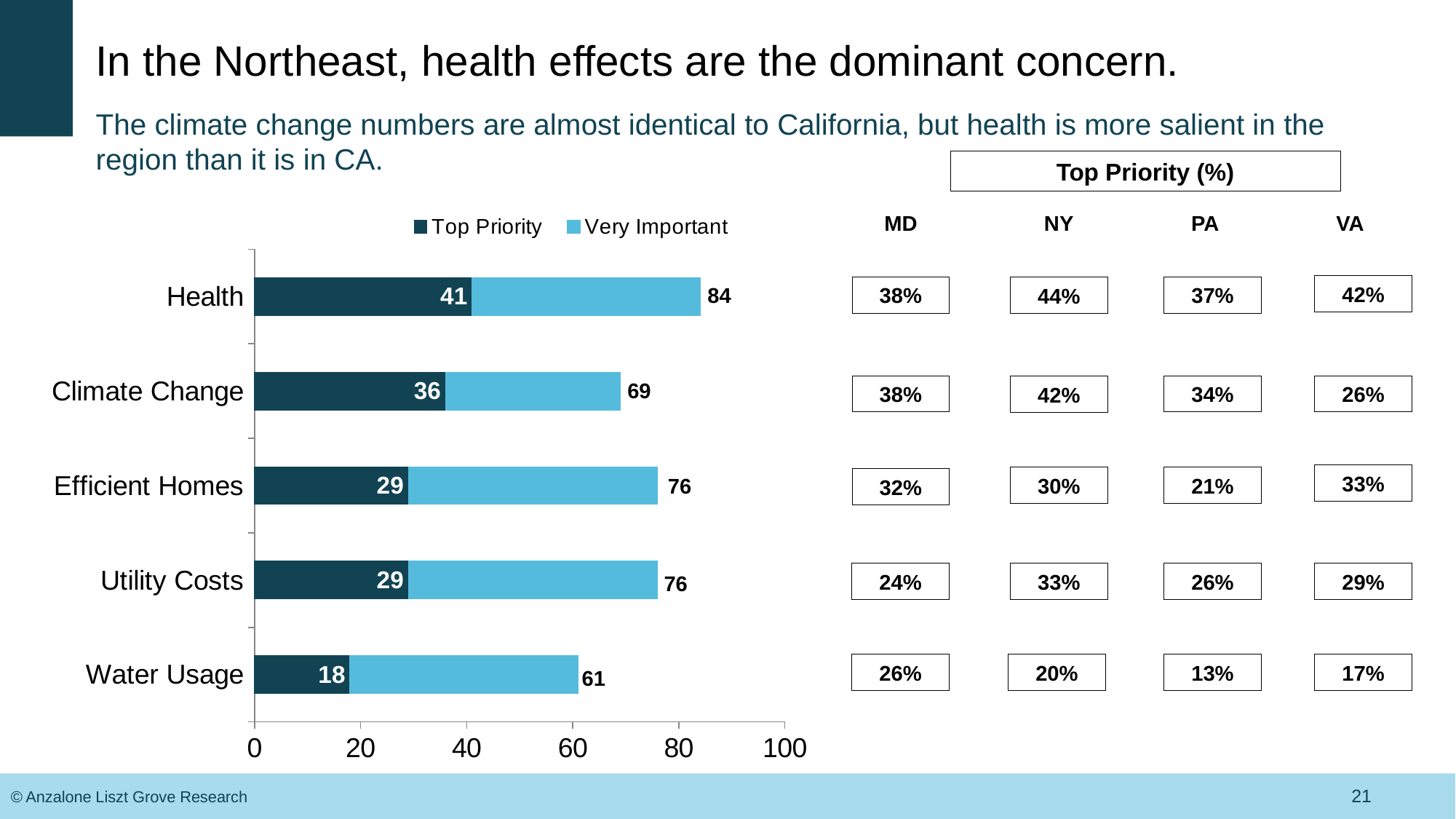
What is the Top Priority value for Water Usage? 18 Which has a larger stacked bar total, Climate Change or Efficient Homes? Efficient Homes How many categories are shown in the chart? 5 How many series does the chart legend list? 2 What is the difference between the Top Priority values for Health and Climate Change? 5 What kind of chart is shown on the slide? Stacked bar chart Which category has the lowest Top Priority value? Water Usage What is the Top Priority value for Climate Change? 36 Which category has the highest Top Priority value? Health What is the Top Priority value for Health? 41 What is the total of the stacked bar for Health? 84 What is the total of the stacked bar for Water Usage? 61